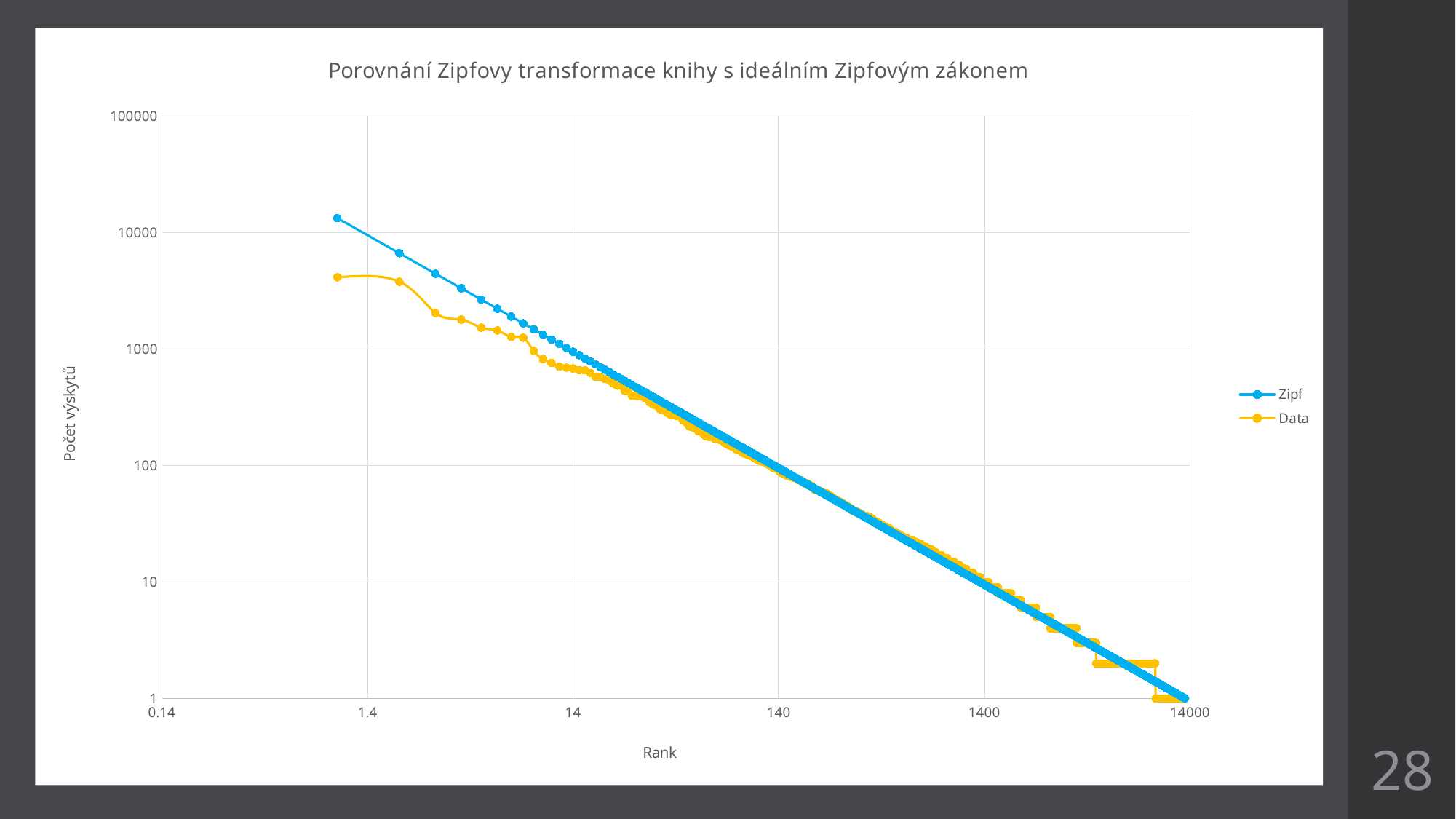
Do the values of the Data series rise or fall as rank increases along the x axis? fall What kind of chart is shown on the slide? line chart Is the first (leftmost) value of the Zipf series greater or less than 10000? greater What is the label of the x axis? Rank Do the values of the Zipf series rise or fall as rank increases along the x axis? fall Is the first (leftmost) value of the Data series greater or less than 10000? less What is the title of the chart? Porovnání Zipfovy transformace knihy s ideálním Zipfovým zákonem How many series does the legend list? 2 At the lowest rank (leftmost point), which series has the higher value, Zipf or Data? Zipf Is the value of the Data series at rank 14 greater or less than 1000? less Around rank 14, which series has the higher value, Zipf or Data? Zipf